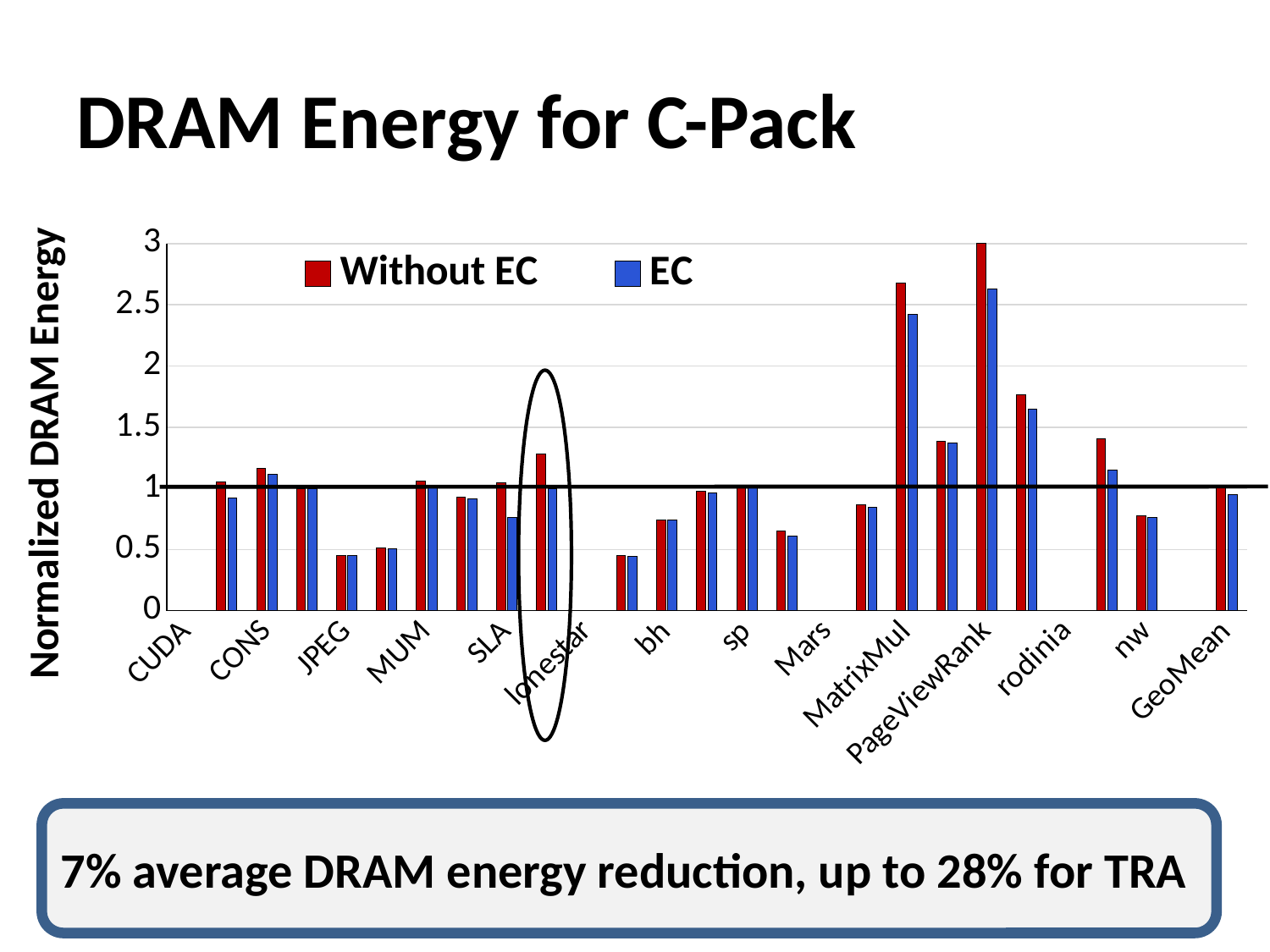
Is the EC value for SLA greater or less than 1? less Which has the larger Without EC value, PageViewRank or MatrixMul? PageViewRank How many series does the legend list? 2 What are the two series named in the legend? Without EC and EC Is the Without EC value for PageViewRank greater or less than 2.5? greater Is the Without EC value for MatrixMul greater or less than 2? greater What kind of chart is shown on the slide? bar chart Which category has the tallest Without EC bar? PageViewRank What is the label on the y-axis of the chart? Normalized DRAM Energy Which is larger for SLA, the Without EC value or the EC value? Without EC